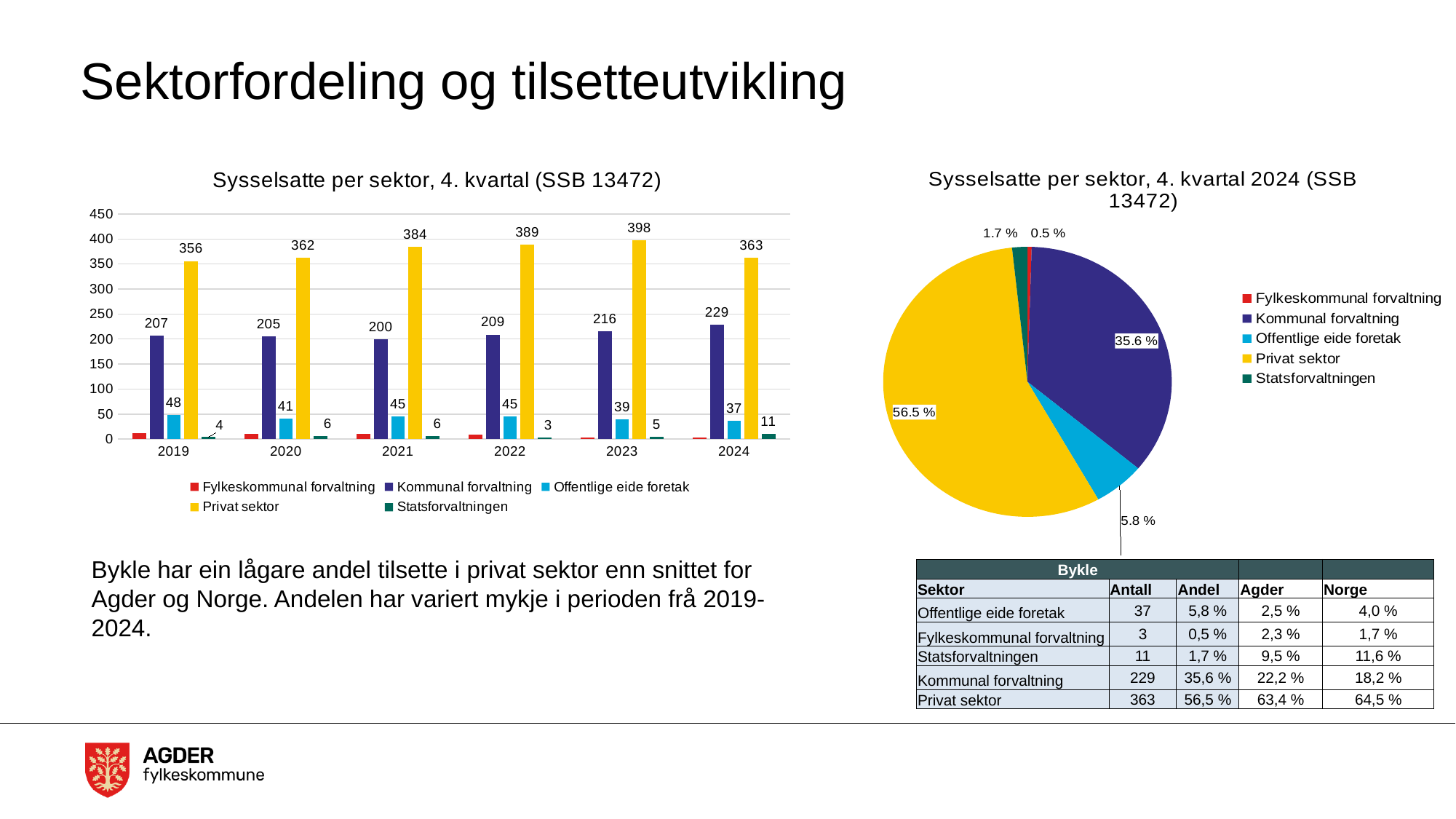
In the pie chart 'Sysselsatte per sektor, 4. kvartal 2024 (SSB 13472)', which sector has the largest slice? Privat sektor In the bar chart 'Sysselsatte per sektor, 4. kvartal (SSB 13472)', what is the value for Privat sektor in 2023? 398 In the bar chart 'Sysselsatte per sektor, 4. kvartal (SSB 13472)', how many series does the legend list? 5 In the bar chart 'Sysselsatte per sektor, 4. kvartal (SSB 13472)', what is the value for Kommunal forvaltning in 2021? 200 In the bar chart 'Sysselsatte per sektor, 4. kvartal (SSB 13472)', in which year is Privat sektor highest? 2023 In the bar chart 'Sysselsatte per sektor, 4. kvartal (SSB 13472)', how many years are shown on the x axis? 6 In the pie chart 'Sysselsatte per sektor, 4. kvartal 2024 (SSB 13472)', what share does Kommunal forvaltning have? 35.6 % In the bar chart 'Sysselsatte per sektor, 4. kvartal (SSB 13472)', in which year is Offentlige eide foretak lowest? 2024 In the bar chart 'Sysselsatte per sektor, 4. kvartal (SSB 13472)', what is the difference between Privat sektor in 2023 and in 2024? 35 In the bar chart 'Sysselsatte per sektor, 4. kvartal (SSB 13472)', is Kommunal forvaltning larger in 2019 or in 2024? 2024 What kind of chart is 'Sysselsatte per sektor, 4. kvartal 2024 (SSB 13472)' on the right of the slide? Pie chart In the bar chart 'Sysselsatte per sektor, 4. kvartal (SSB 13472)', what is the value for Statsforvaltningen in 2024? 11